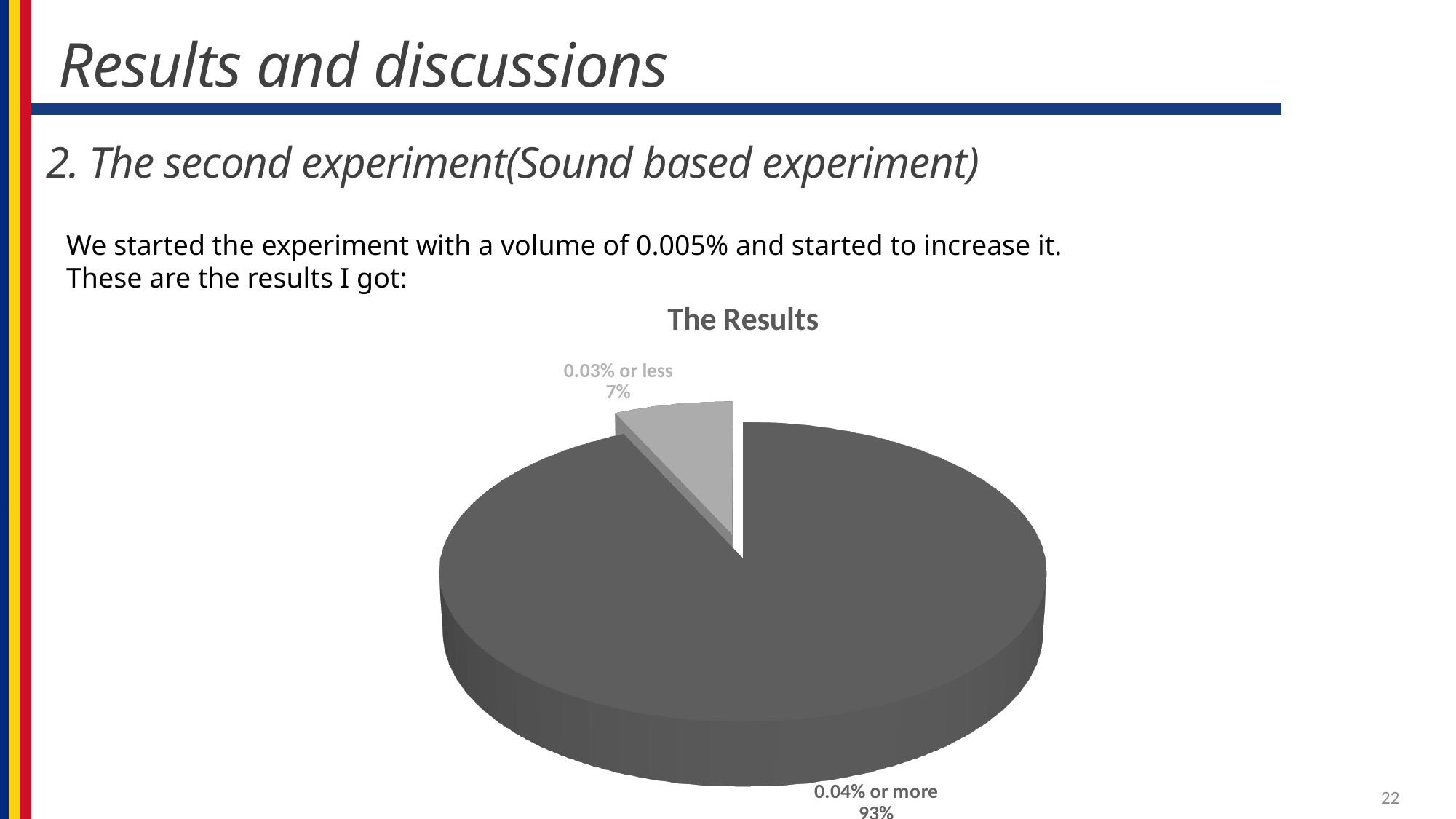
Is the share for "0.04% or more" greater or less than 50%? greater What kind of chart is shown on the slide? pie chart Which slice is shown in the lighter grey colour? 0.03% or less Which slice is larger, "0.03% or less" or "0.04% or more"? 0.04% or more Which slice of the pie is the largest? 0.04% or more What share of the pie does the "0.03% or less" slice represent? 7% How many slices does the pie chart have? 2 Which slice of the pie is the smallest? 0.03% or less What is the title of the chart? The Results What share of the pie does the "0.04% or more" slice represent? 93% What is the difference in percentage points between the "0.04% or more" slice and the "0.03% or less" slice? 86